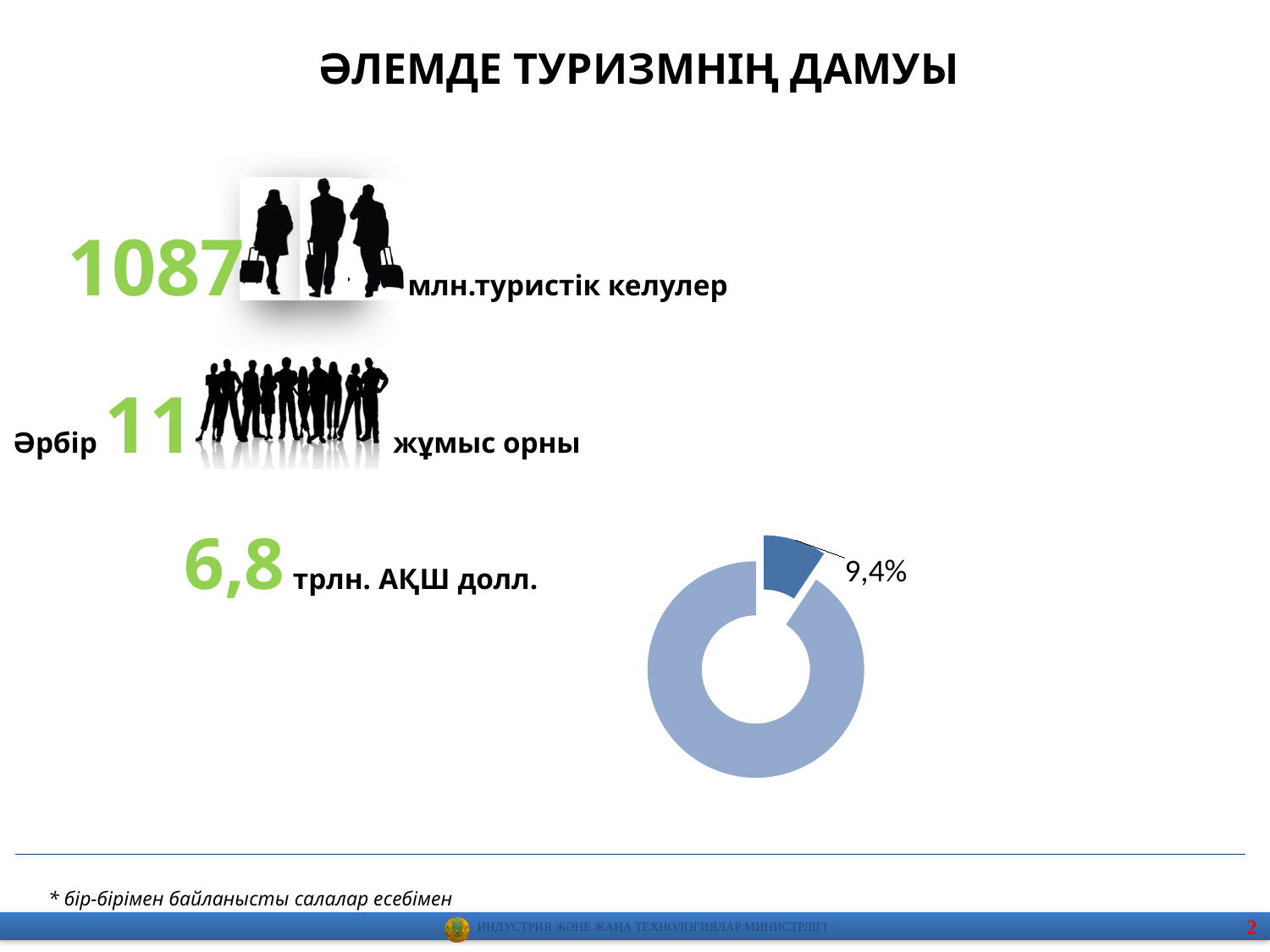
Which slice of the doughnut chart is larger, the dark blue one or the light blue one? the light blue one How many data labels are printed on the doughnut chart? 1 How many slices does the doughnut chart have? 2 What share of the doughnut chart does the dark blue slice represent? 9,4% What value is printed on the dark blue slice of the doughnut chart? 9,4% Which slice of the doughnut chart is the smallest? the dark blue slice What kind of chart is shown on the slide? doughnut chart Is the light blue slice of the doughnut chart greater or less than 50% of the whole? greater Is the small slice of the doughnut chart pulled out (exploded) from the rest of the ring? yes